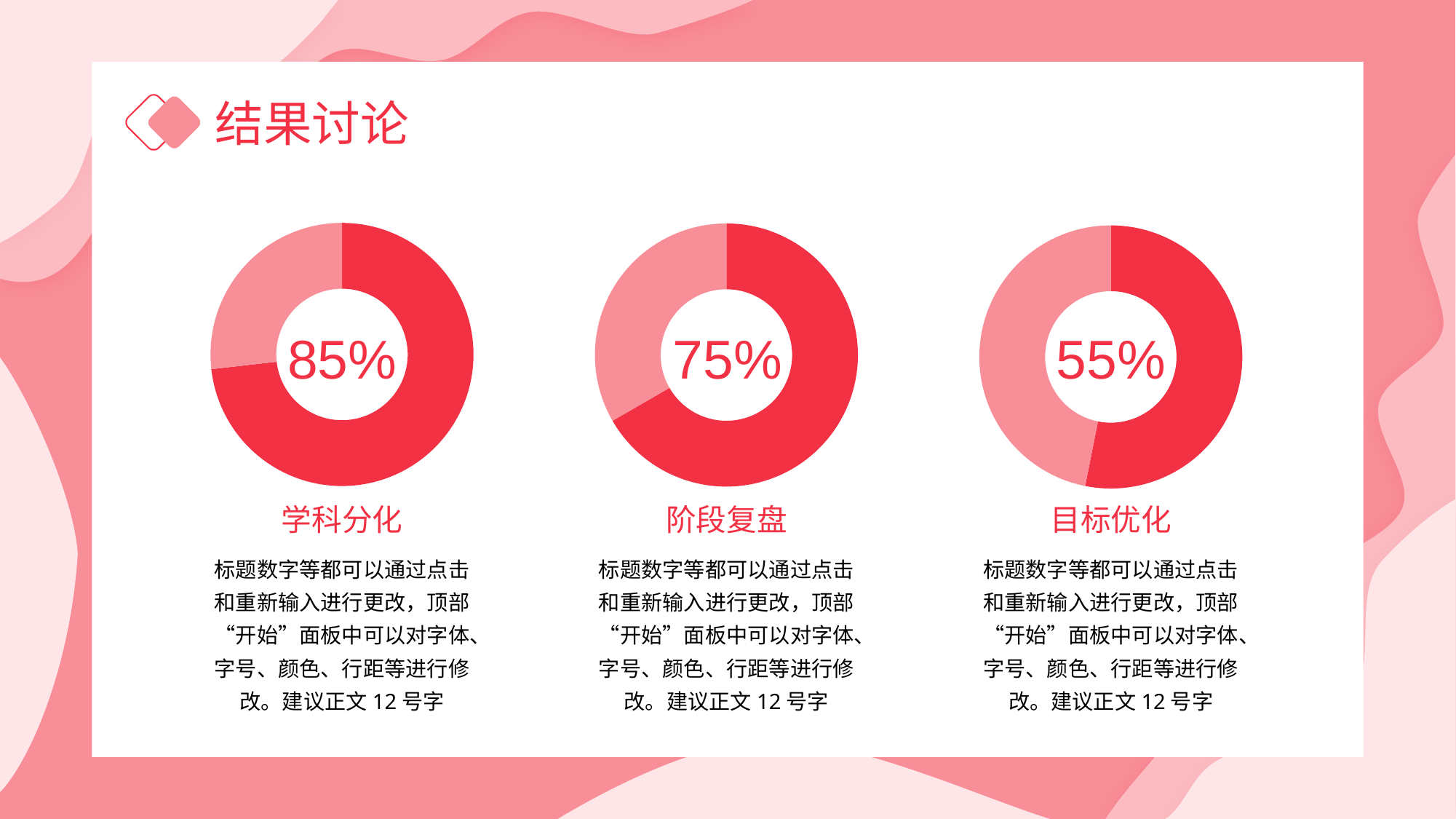
Which of the three donut charts shows the highest percentage? 学科分化 What is the title of the slide containing the three donut charts? 结果讨论 How many donut charts are on the slide? 3 In the 目标优化 donut chart, which colour represents the 55% portion, the darker red or the lighter pink? Darker red What percentage is shown in the centre of the 目标优化 donut chart? 55% What percentage is shown in the centre of the 学科分化 donut chart? 85% What kind of chart is used to show the 85% value for 学科分化? Donut chart What percentage is shown in the centre of the 阶段复盘 donut chart? 75% Which is larger, the percentage for 阶段复盘 or the percentage for 目标优化? 阶段复盘 What is the difference between the percentage for 阶段复盘 and the percentage for 目标优化? 20% Which of the three donut charts shows the lowest percentage? 目标优化 What is the difference between the percentage for 学科分化 and the percentage for 阶段复盘? 10%